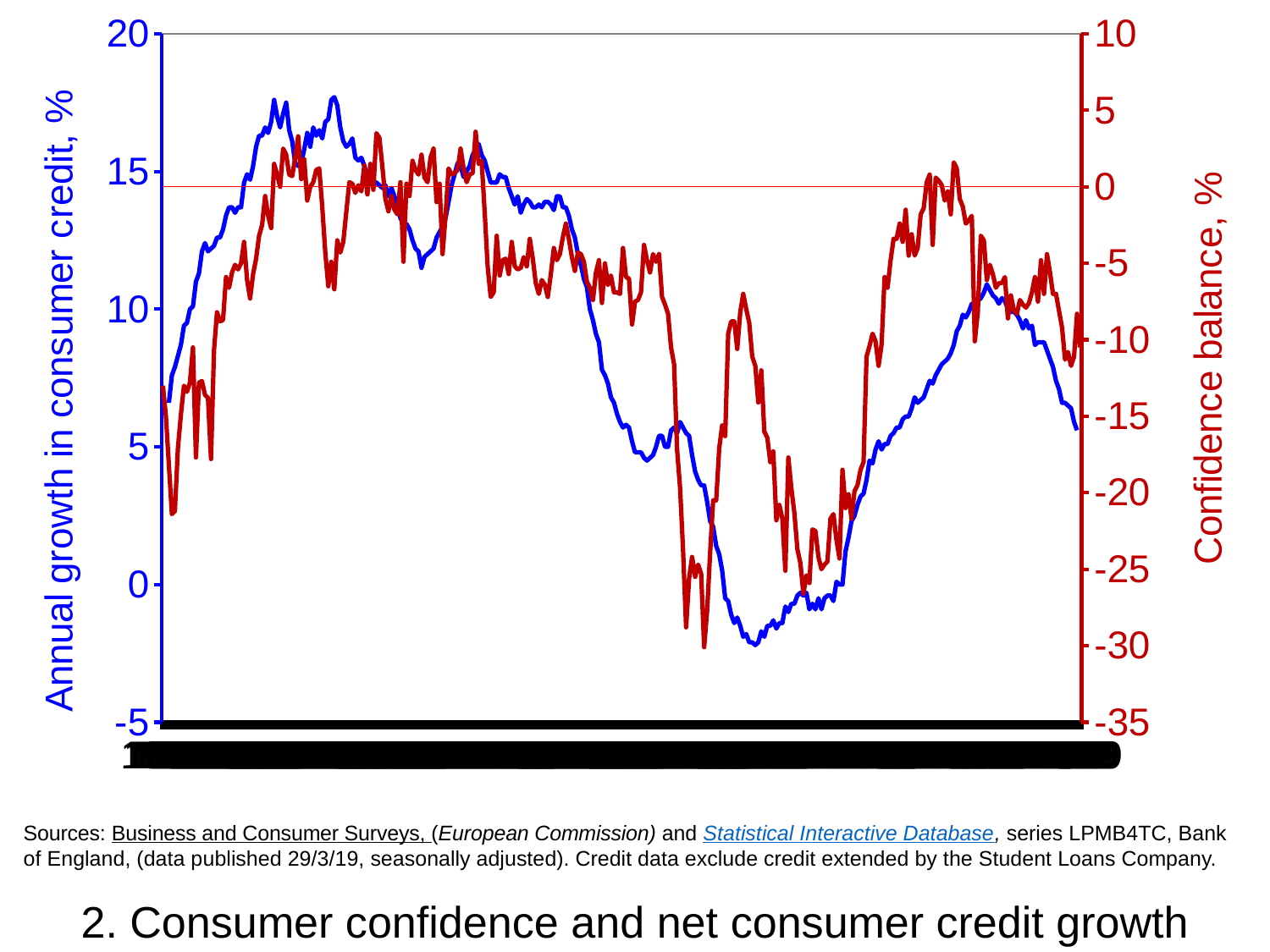
Is the highest point of the blue line (annual growth in consumer credit) greater or less than 20 on the left axis? less How many data series are plotted on the chart? 2 What is the title of the chart on the slide? 2. Consumer confidence and net consumer credit growth What is the title of the left-hand (blue) vertical axis? Annual growth in consumer credit, % Is the lowest point of the blue line (annual growth in consumer credit) greater or less than 0 on the left axis? less What kind of chart is shown on the slide? Line chart Is the highest point of the blue line (annual growth in consumer credit) greater or less than 15 on the left axis? greater